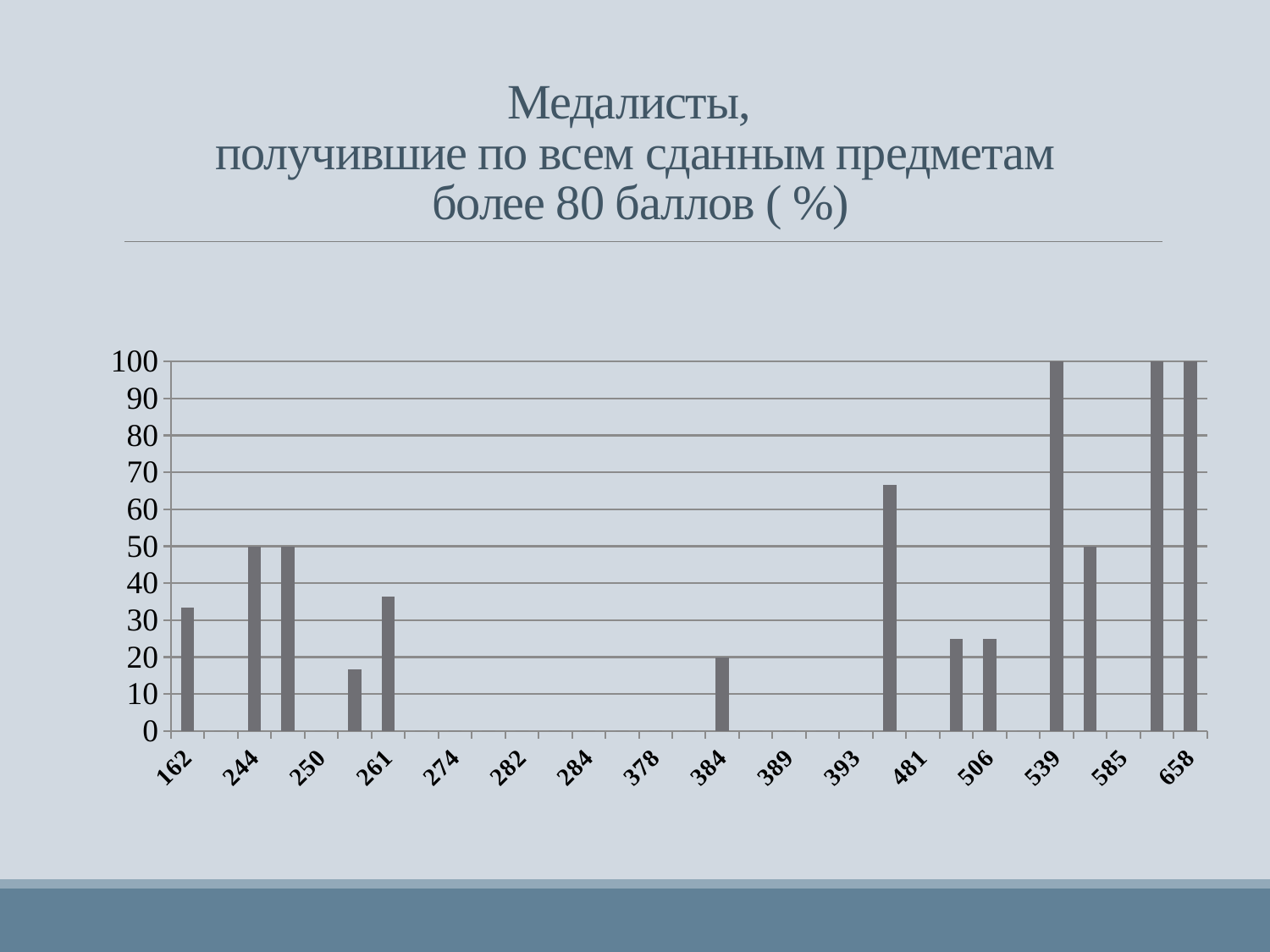
Is the value for 658 greater or less than 90? greater Which has the larger value, 658 or 162? 658 Is the value for 274 greater or less than 10? less Which has the larger value, 244 or 384? 244 Is the value for 244 greater or less than 40? greater How many category labels are shown on the x axis? 16 What kind of chart is shown on the slide? bar chart What is the title of the chart? Медалисты, получившие по всем сданным предметам более 80 баллов ( %)